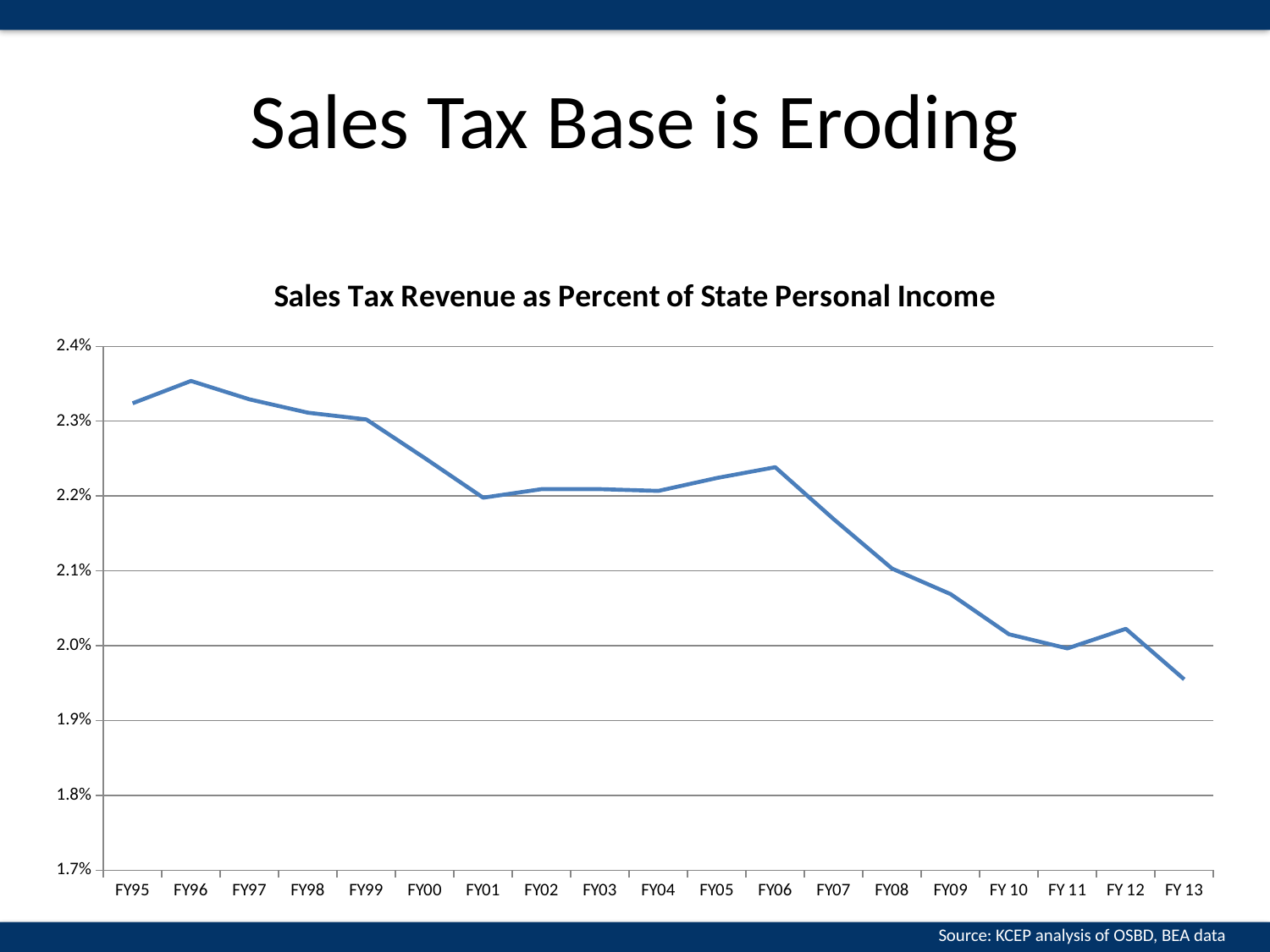
Is the value for FY06 greater or less than 2.2%? greater Overall, do the values rise or fall from FY95 to FY 13? fall Which fiscal year has the highest value? FY96 Which is larger, the value for FY06 or the value for FY08? FY06 How many fiscal years are plotted on the x axis? 19 Is the value for FY 13 greater or less than 2.0%? less What is the title of the chart? Sales Tax Revenue as Percent of State Personal Income Which fiscal year has the lowest value? FY 13 Which is larger, the value for FY99 or the value for FY01? FY99 Is the value for FY09 greater or less than 2.1%? less What type of chart is shown on the slide? line chart